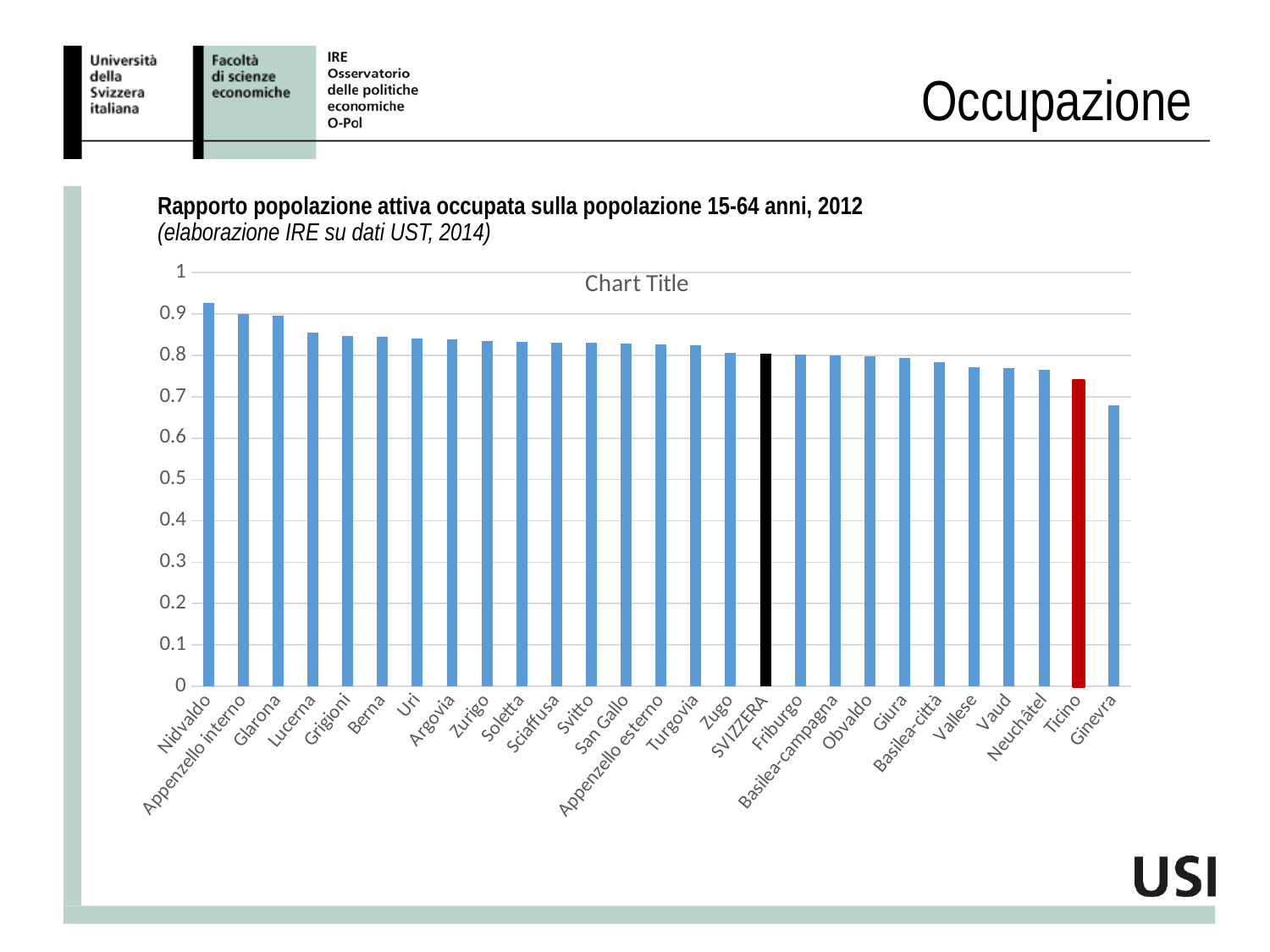
Which category has the lowest value in the chart? Ginevra What kind of chart is shown on the slide? bar chart Which category has the highest value in the chart? Nidvaldo How many bars (categories) are plotted in the chart? 27 Is the value for Nidvaldo greater or less than 0.9? greater Do the bar values generally rise or fall from left to right along the x axis? fall Is the value for Ticino greater or less than 0.8? less What colour is the bar for SVIZZERA? black Which has a larger value, Ticino or Ginevra? Ticino Is the value for Ticino greater or less than 0.7? greater What colour is the bar for Ticino? red